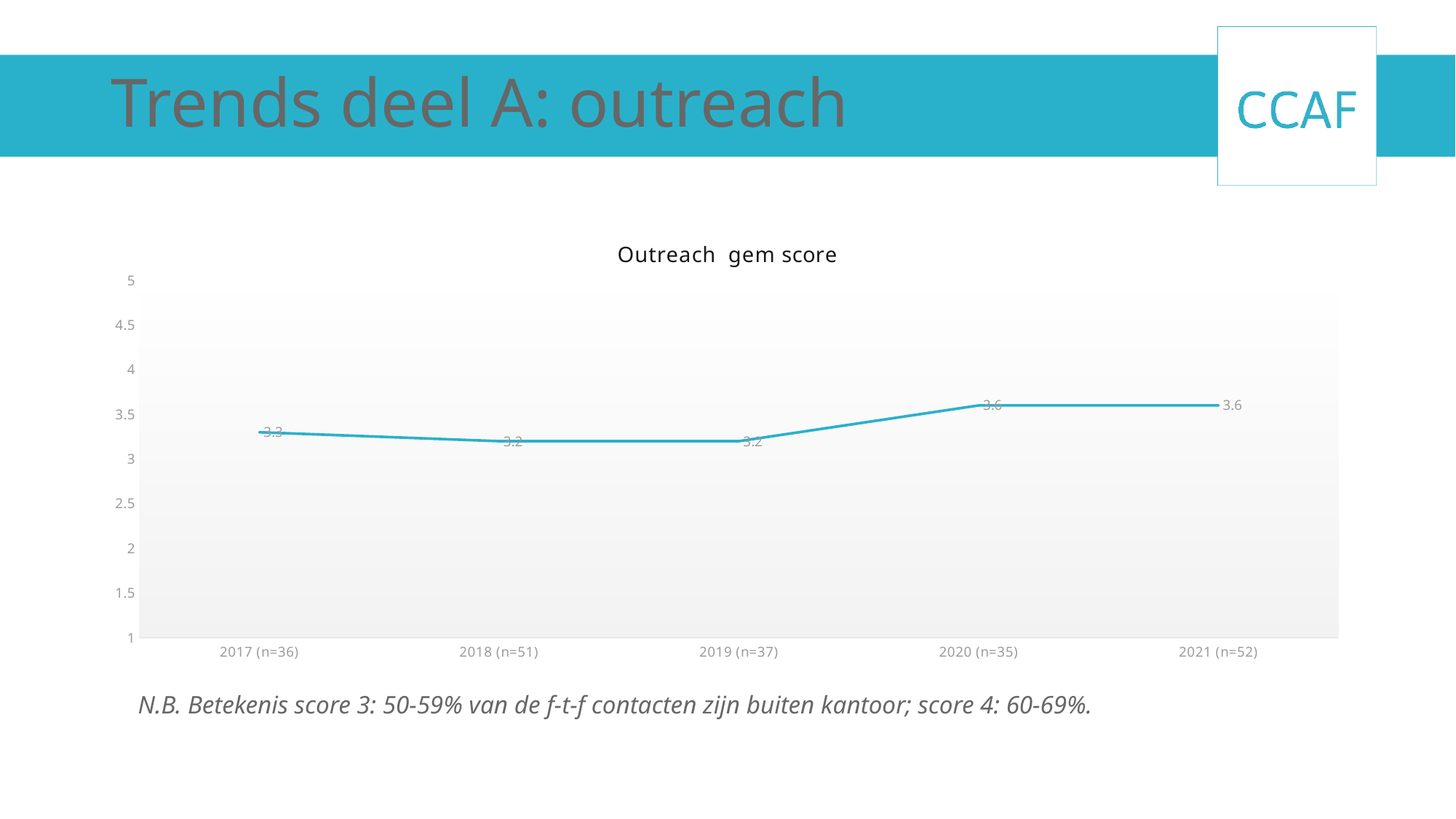
What is the title of the chart? Outreach gem score Which year has the lowest Outreach gem score, 2017 or 2018? 2018 (n=51) What is the Outreach gem score for 2017 (n=36)? 3.3 Is the Outreach gem score for 2018 (n=51) greater or less than 3.5? less What kind of chart is shown on the slide? Line chart What is the Outreach gem score for 2019 (n=37)? 3.2 Does the Outreach gem score rise or fall from 2019 to 2020? Rise What is the Outreach gem score for 2021 (n=52)? 3.6 What is the difference between the Outreach gem score in 2020 (n=35) and in 2019 (n=37)? 0.4 How many data points are plotted on the Outreach gem score chart? 5 Is the Outreach gem score for 2020 (n=35) greater or less than 3.5? greater What is the difference between the Outreach gem score in 2021 (n=52) and in 2017 (n=36)? 0.3